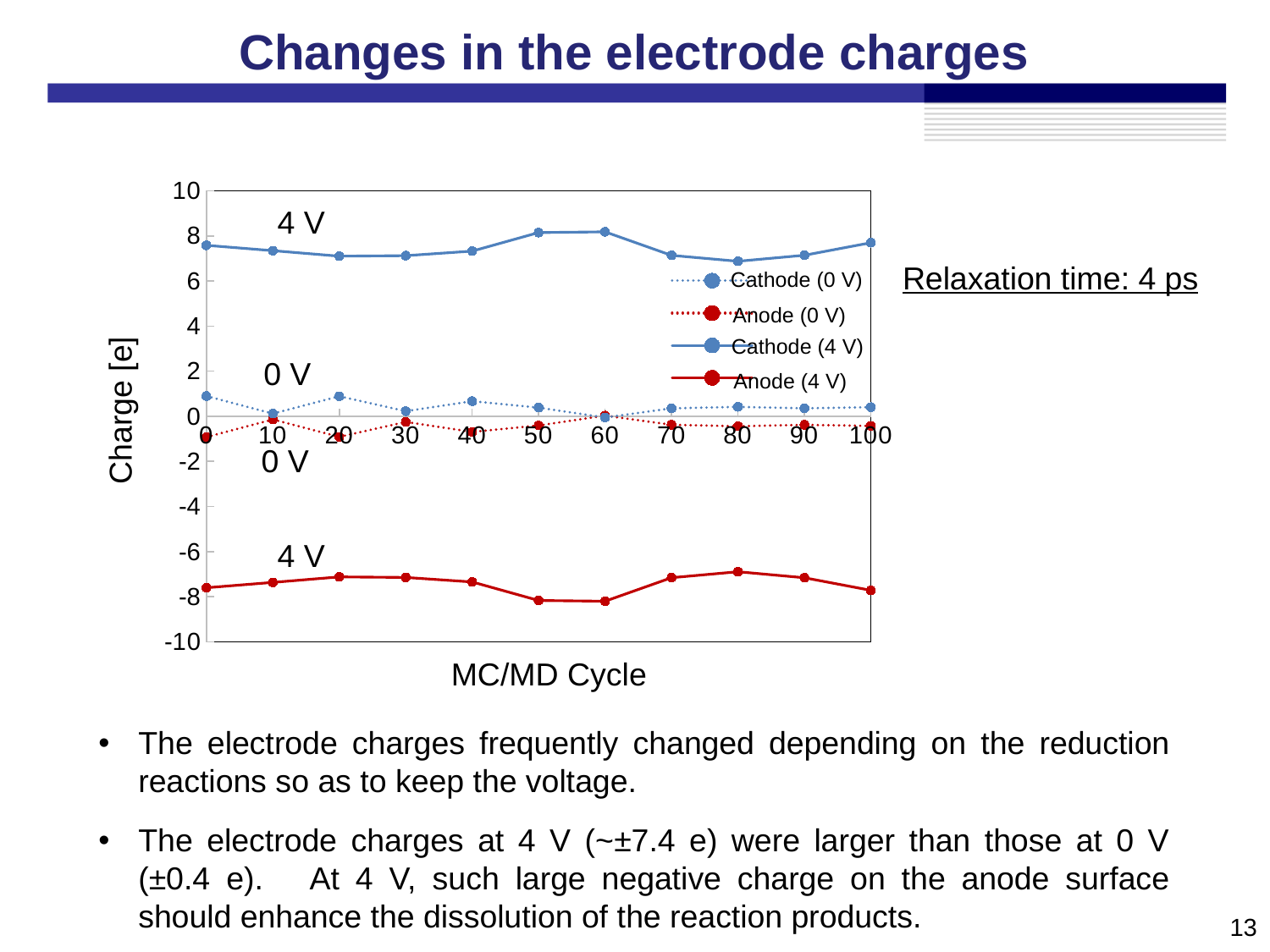
At cycle 50, which is larger: Cathode (4 V) or Cathode (0 V)? Cathode (4 V) Does the Cathode (4 V) series rise or fall from cycle 60 to cycle 80? fall What is the title of the x axis? MC/MD Cycle Which series has the highest charge values across the chart? Cathode (4 V) What kind of chart is shown on the slide? line chart Is the value for Cathode (4 V) at cycle 80 greater or less than 8? less Is the value for Anode (4 V) at cycle 50 greater or less than -6? less Is the value for Cathode (0 V) at cycle 20 greater or less than 2? less How many data points are plotted for the Cathode (4 V) series? 11 How many series does the legend list? 4 Which series has the lowest charge values across the chart? Anode (4 V)